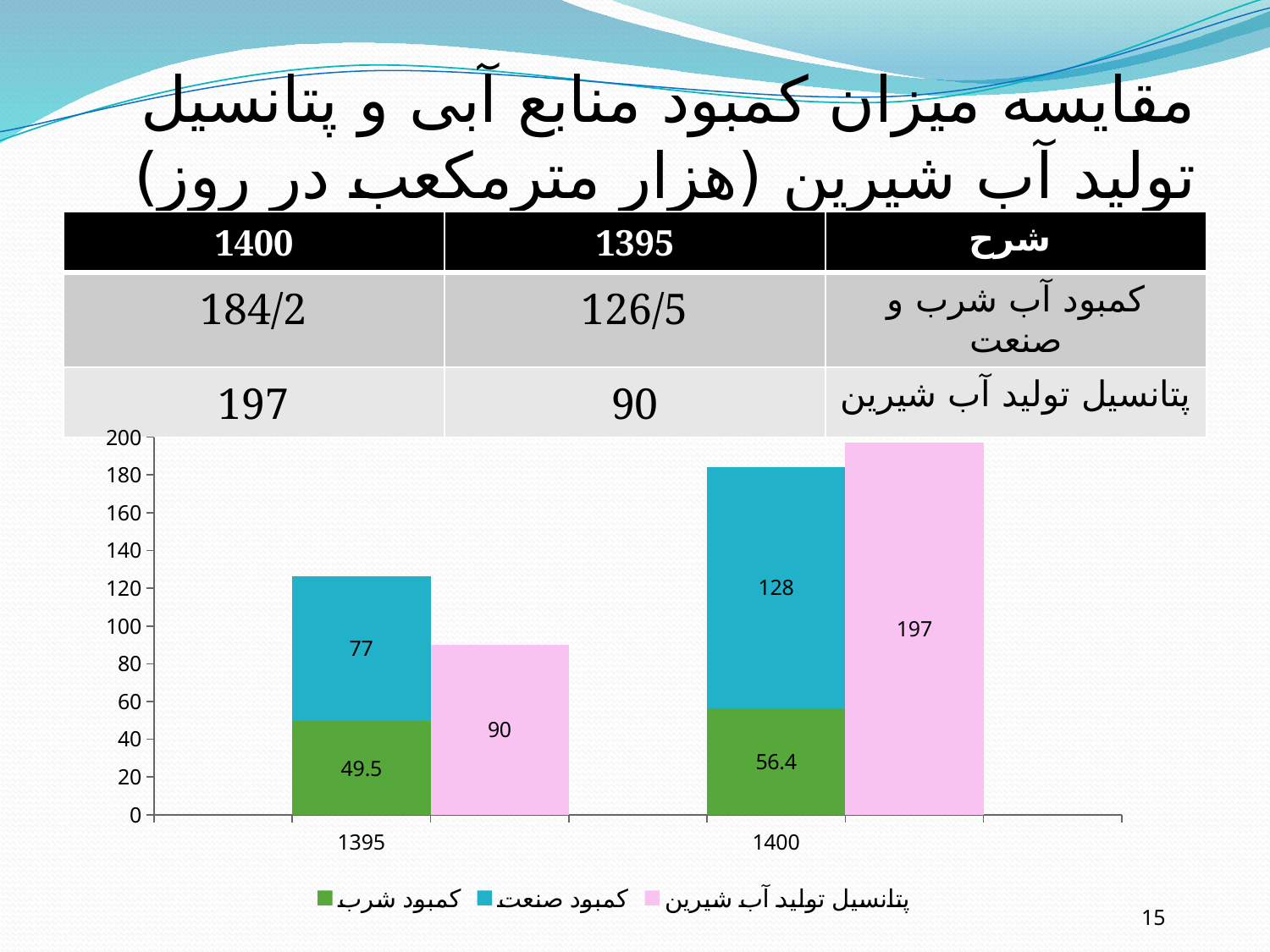
What is the value for کمبود صنعت in 1400? 128 What is the value for پتانسیل تولید آب شیرین in 1400? 197 What is the total of the stacked bar for 1395 (کمبود شرب plus کمبود صنعت)? 126.5 Which is larger: کمبود صنعت in 1395 or پتانسیل تولید آب شیرین in 1395? پتانسیل تولید آب شیرین in 1395 What is the value for کمبود شرب in 1400? 56.4 What is the value for پتانسیل تولید آب شیرین in 1395? 90 What kind of chart is shown on the slide? Stacked bar chart What is the difference between the پتانسیل تولید آب شیرین values for 1400 and 1395? 107 What is the value for کمبود شرب in 1395? 49.5 How many categories are shown on the x axis? 2 How many series does the legend list? 3 What is the difference between the کمبود صنعت values for 1400 and 1395? 51